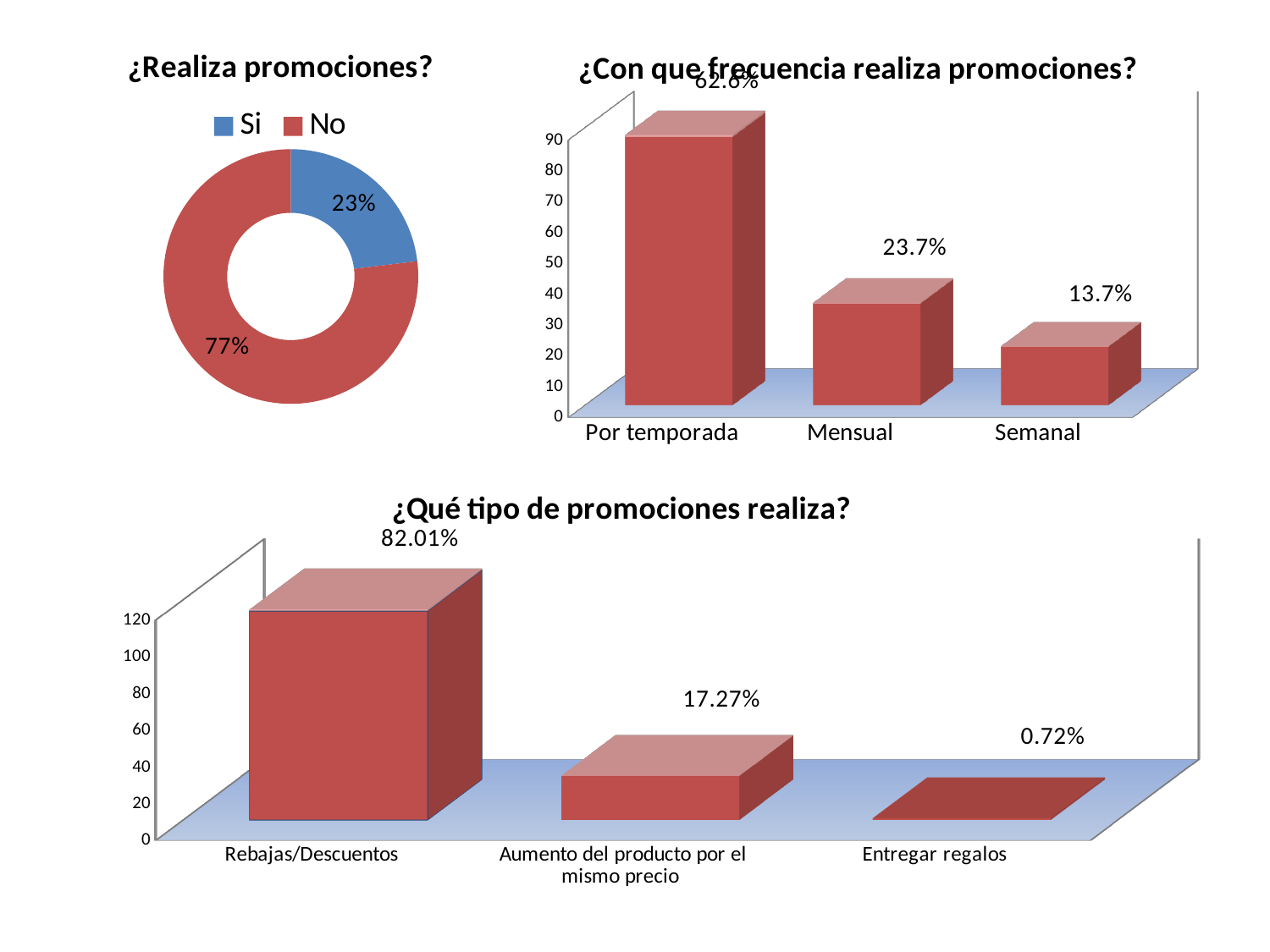
In the chart titled "¿Con que frecuencia realiza promociones?", which category has the highest value? Por temporada In the chart titled "¿Con que frecuencia realiza promociones?", which category has the lowest value? Semanal In the chart titled "¿Realiza promociones?", what share of the donut is labelled "No"? 77% In the chart titled "¿Con que frecuencia realiza promociones?", what is the value for "Mensual"? 23.7% In the chart titled "¿Qué tipo de promociones realiza?", do the values rise or fall from left to right along the x axis? Fall In the chart titled "¿Qué tipo de promociones realiza?", how many categories are shown on the x axis? 3 In the chart titled "¿Con que frecuencia realiza promociones?", what is the difference between the values for "Mensual" and "Semanal"? 10.0% In the chart titled "¿Qué tipo de promociones realiza?", what is the value for "Entregar regalos"? 0.72% In the chart titled "¿Qué tipo de promociones realiza?", what is the value for "Rebajas/Descuentos"? 82.01% What kind of chart is the one titled "¿Realiza promociones?"? Donut (pie) chart In the chart titled "¿Realiza promociones?", what is the value for "Si"? 23% How many entries does the legend of the chart titled "¿Realiza promociones?" list? 2